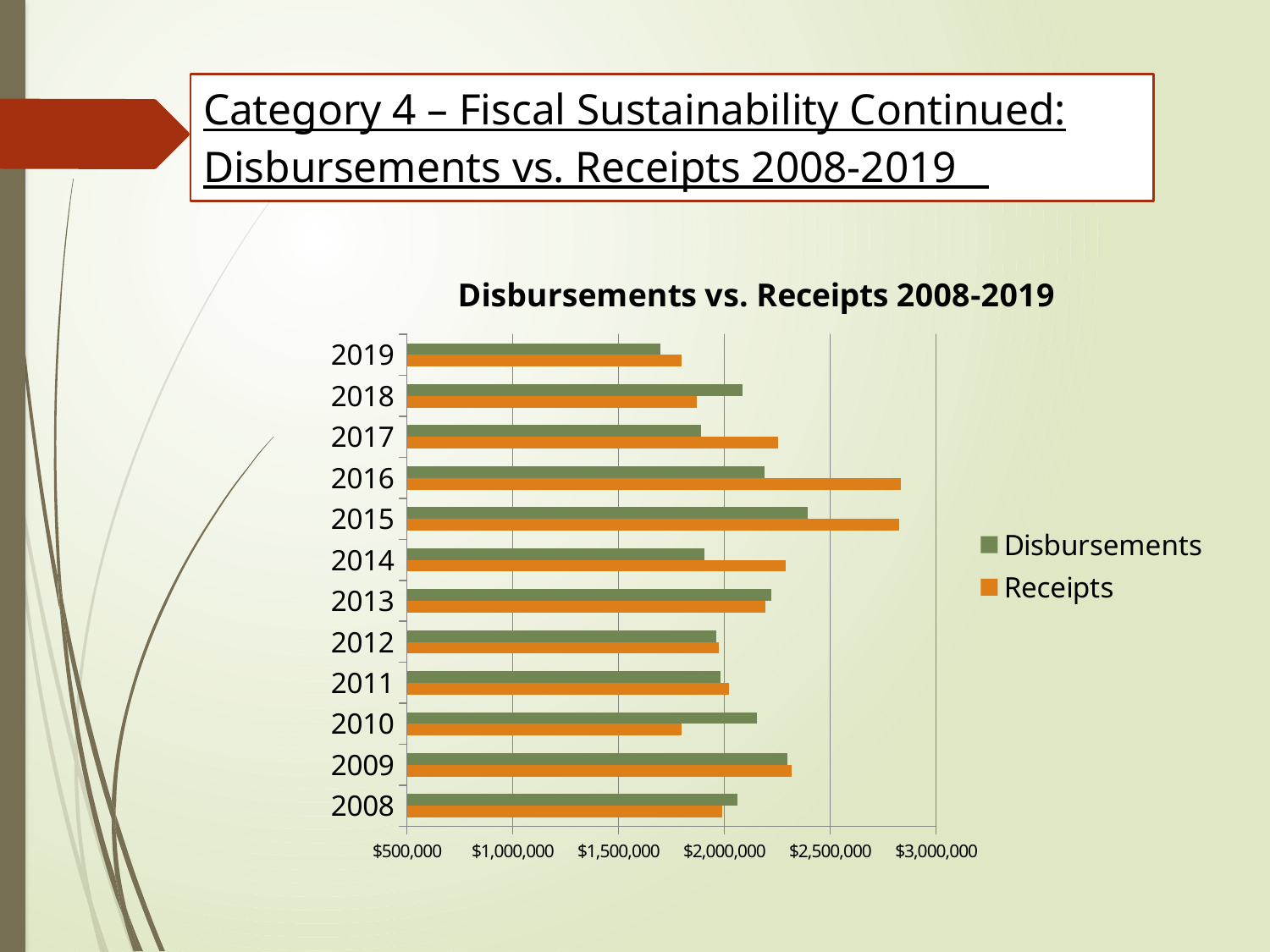
Which colour represents Receipts in the chart? Orange How many series does the legend list? 2 In 2016, which is larger, Disbursements or Receipts? Receipts How many years are shown on the chart? 12 Is the value for Receipts in 2010 greater or less than $2,000,000? less In 2010, which is larger, Disbursements or Receipts? Disbursements Is the value for Receipts in 2016 greater or less than $2,500,000? greater Is the value for Disbursements in 2019 greater or less than $2,000,000? less What kind of chart is shown on the slide? Bar chart What is the title of the chart? Disbursements vs. Receipts 2008-2019 Which year has the lowest Disbursements value? 2019